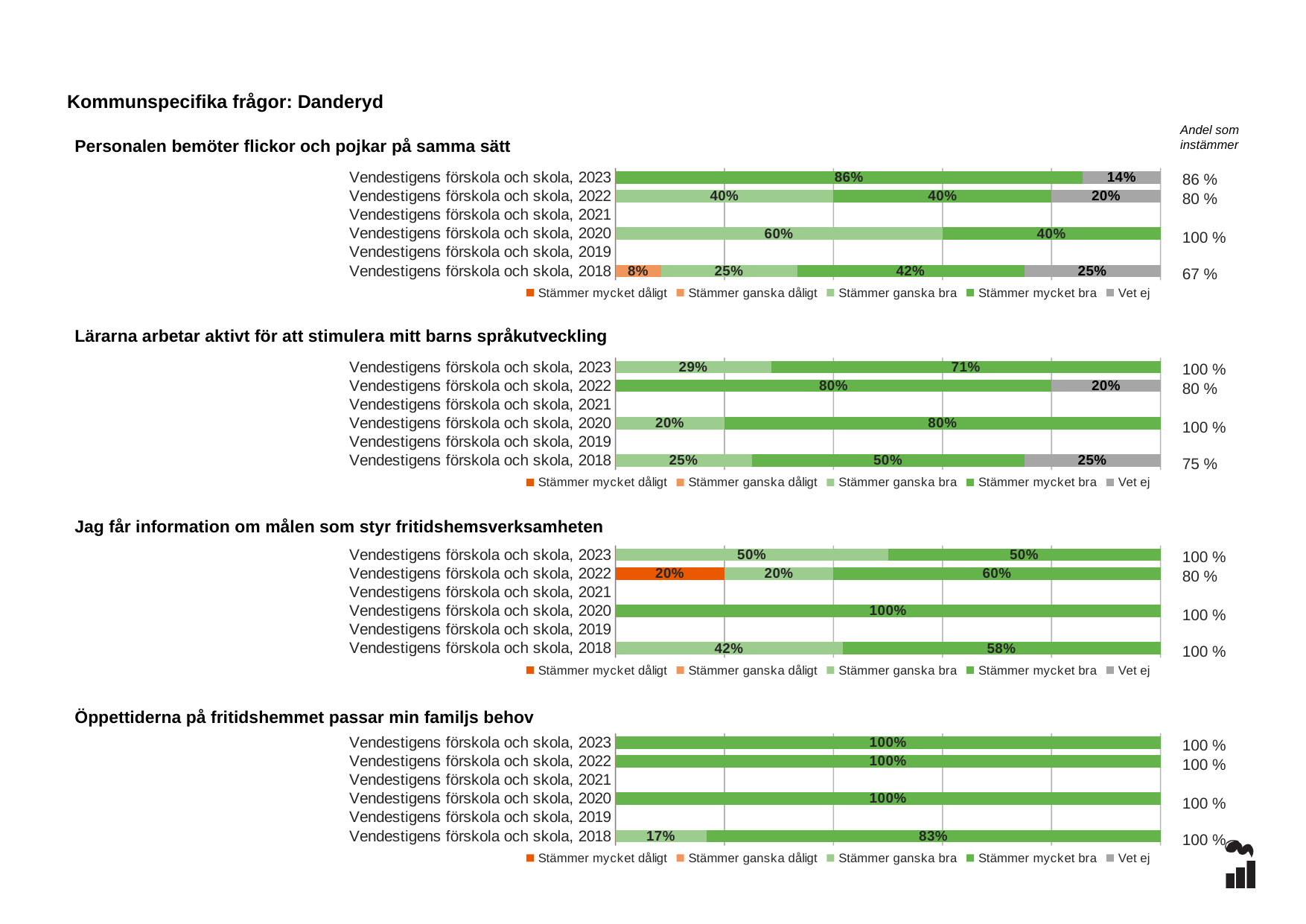
What kind of chart is 'Lärarna arbetar aktivt för att stimulera mitt barns språkutveckling'? Stacked bar chart In the chart 'Personalen bemöter flickor och pojkar på samma sätt', what is the 'Stämmer mycket bra' value for Vendestigens förskola och skola, 2023? 86% In the chart 'Jag får information om målen som styr fritidshemsverksamheten', which year has the highest 'Stämmer mycket bra' value? 2020 In the chart 'Öppettiderna på fritidshemmet passar min familjs behov', what is the 'Stämmer mycket bra' value for Vendestigens förskola och skola, 2018? 83% How many series does the legend list for the chart 'Personalen bemöter flickor och pojkar på samma sätt'? 5 In the chart 'Personalen bemöter flickor och pojkar på samma sätt', what is the 'Vet ej' value for Vendestigens förskola och skola, 2018? 25% In the chart 'Lärarna arbetar aktivt för att stimulera mitt barns språkutveckling', what is the 'Stämmer ganska bra' value for Vendestigens förskola och skola, 2023? 29% In the chart 'Personalen bemöter flickor och pojkar på samma sätt', what is the 'Andel som instämmer' value for Vendestigens förskola och skola, 2018? 67 % In the chart 'Öppettiderna på fritidshemmet passar min familjs behov', is the 'Stämmer mycket bra' value for 2018 larger or smaller than the 'Stämmer ganska bra' value for 2018? larger In the chart 'Jag får information om målen som styr fritidshemsverksamheten', what is the 'Stämmer mycket dåligt' value for Vendestigens förskola och skola, 2022? 20% In the chart 'Lärarna arbetar aktivt för att stimulera mitt barns språkutveckling', what is the difference between the 'Stämmer mycket bra' values for 2022 and 2018? 30% In the chart 'Personalen bemöter flickor och pojkar på samma sätt', what is the total of the 'Stämmer ganska bra' and 'Stämmer mycket bra' segments for 2022? 80%